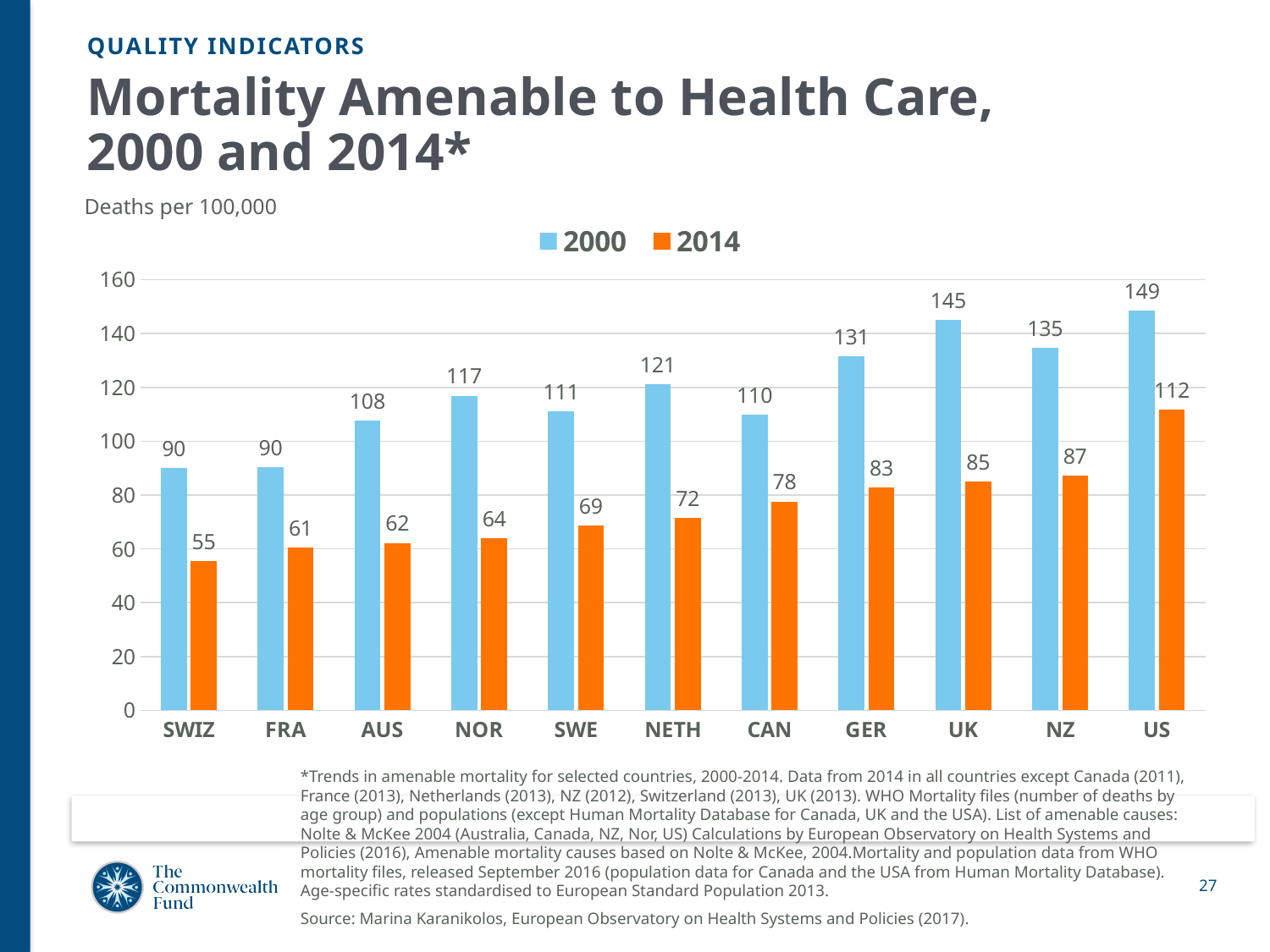
Which country had the highest value in 2014? US What was the value for SWIZ in 2014? 55 What is the difference between the 2000 and 2014 values for the UK? 60 What unit is the chart measured in, according to the subtitle? Deaths per 100,000 Which is larger, the 2014 value for GER or the 2014 value for NZ? NZ What kind of chart is shown on the slide? bar chart How many series does the legend list? 2 Which country had the lowest value in 2014? SWIZ Which colour represents the 2014 series in the legend? orange What was the mortality amenable to health care for the US in 2000? 149 How many countries are shown on the x axis? 11 Is the 2000 value for NETH greater or less than 120? greater